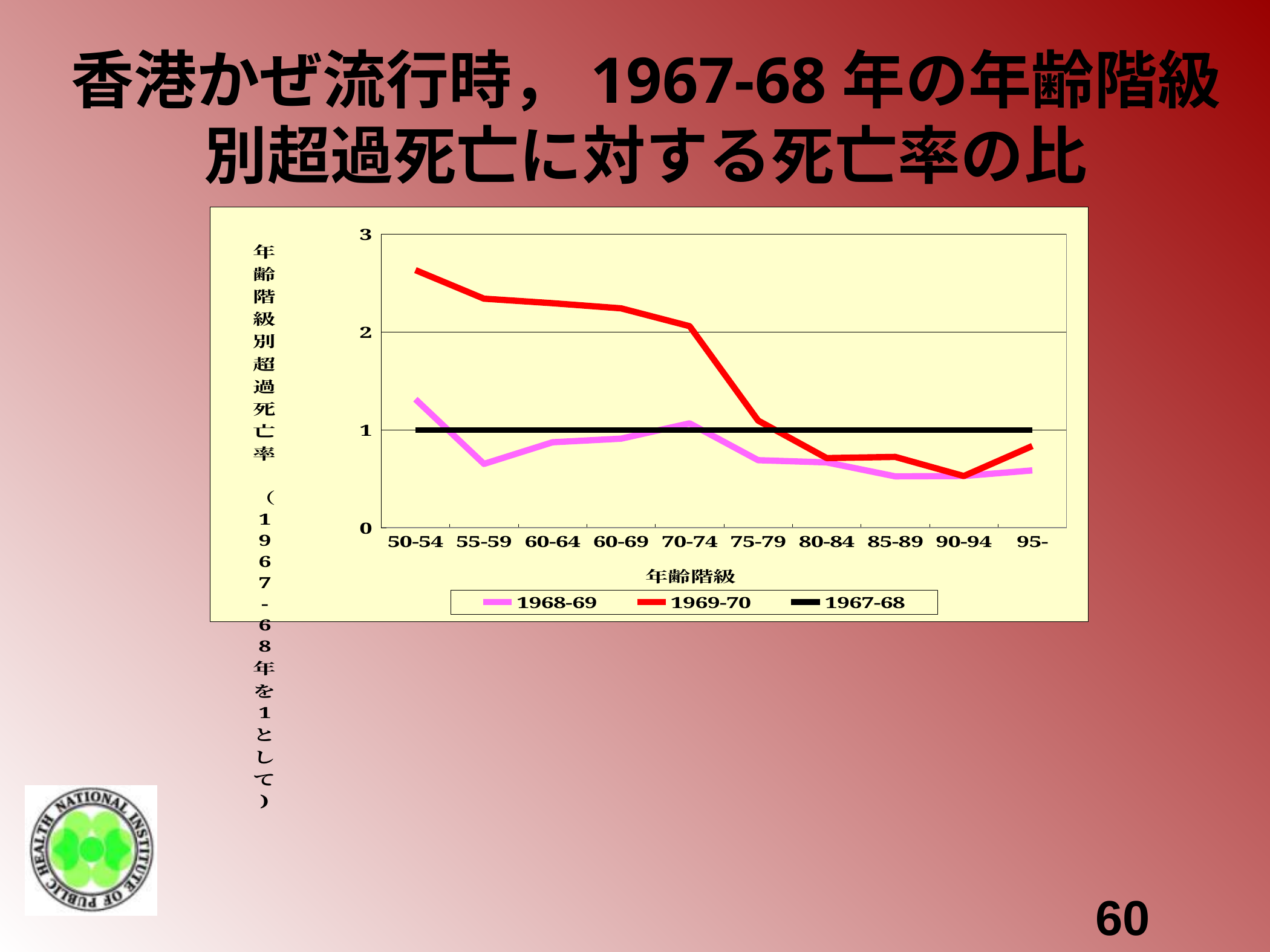
Is the value for 1968-69 at 55-59 greater or less than 1? less What kind of chart is shown on the slide? line chart Does the 1969-70 series generally rise or fall from 50-54 to 90-94? fall How many series does the legend list? 3 Is the value for 1969-70 at 50-54 greater or less than 2? greater Is the value for 1969-70 at 85-89 greater or less than 1? less What is the value of the 1967-68 series across all age groups? 1 How many age-group categories are shown on the x axis? 10 For the 1969-70 series, which age group has the lowest value? 90-94 For the 1969-70 series, which age group has the highest value? 50-54 At 50-54, which series has the larger value, 1968-69 or 1969-70? 1969-70